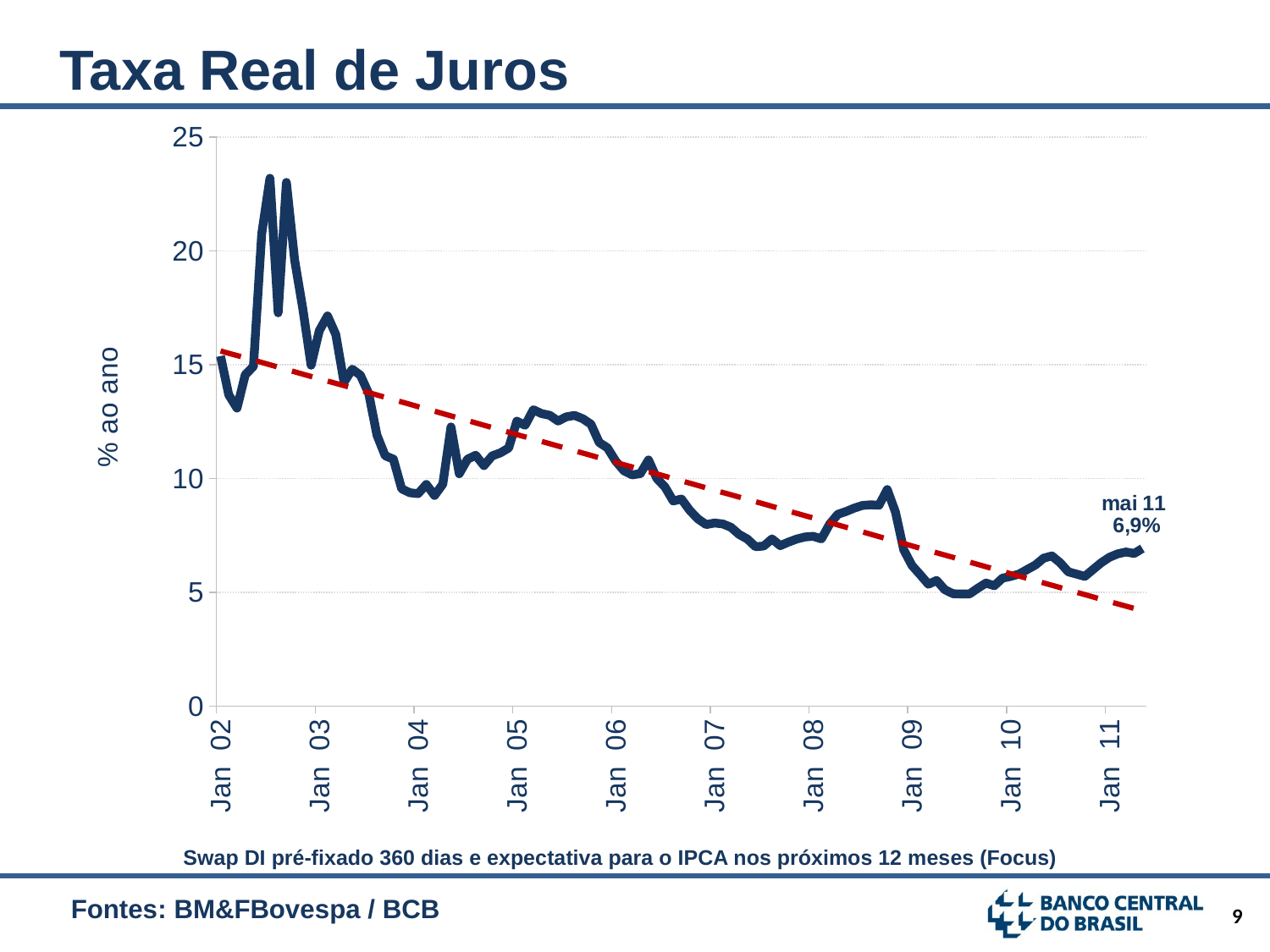
Is the peak value reached in 2002 greater or less than 20? greater Overall, does the real interest rate rise or fall from Jan 02 to Jan 11? fall What value is labelled for mai 11 on the chart? 6,9% Is the value at Jan 07 greater or less than 10? less Which is larger, the value at Jan 05 or the value at Jan 08? Jan 05 What is the title of the y axis? % ao ano Is the value at Jan 09 greater or less than 10? less How many year labels are shown on the x axis? 10 What kind of chart is shown on the slide? line chart